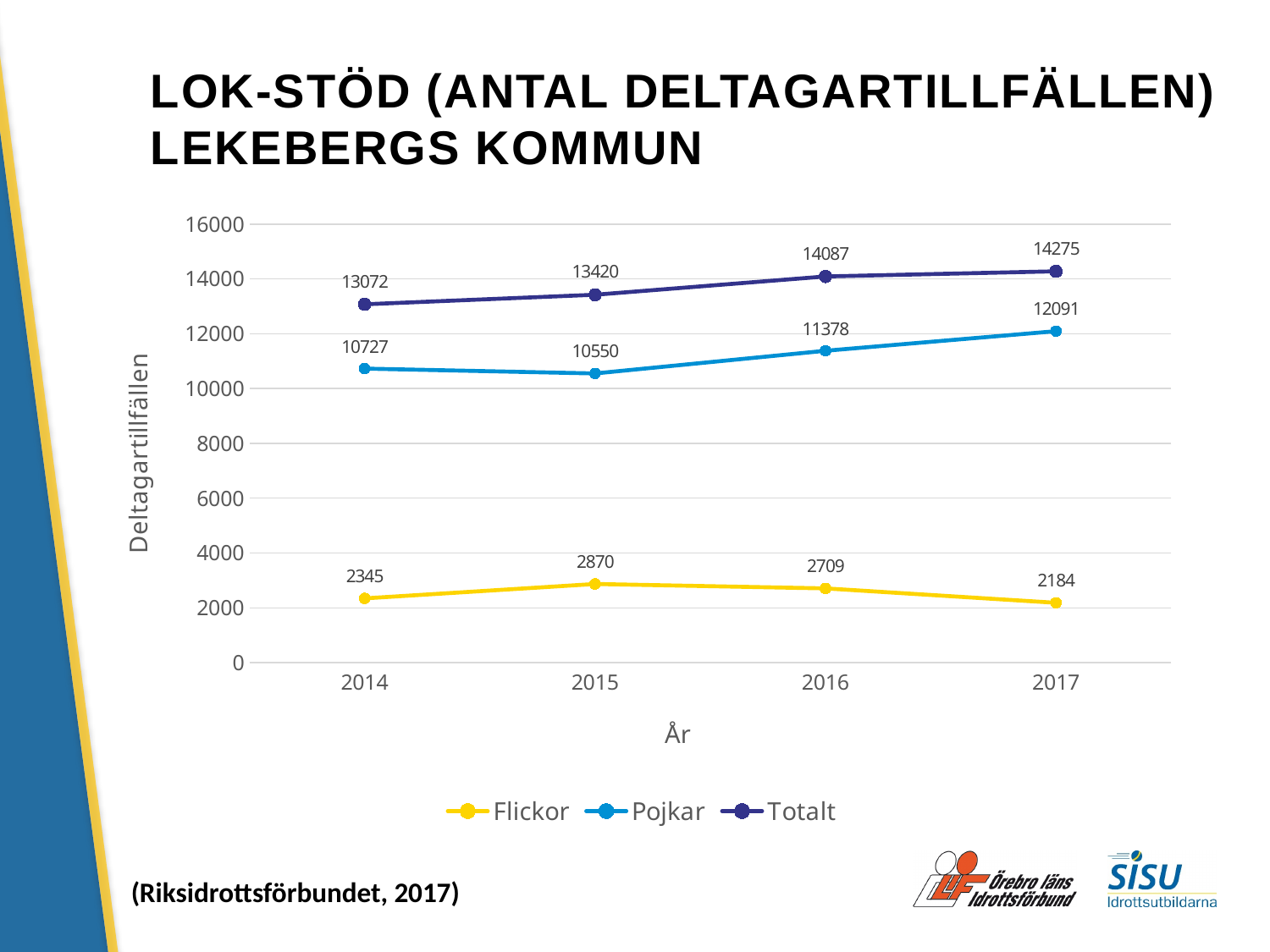
What is the value for Flickor in 2015? 2870 How many years are shown on the x axis? 4 How many series does the legend list? 3 In which year is the Totalt series highest? 2017 What is the value for Totalt in 2014? 13072 What is the difference between the Pojkar values in 2017 and 2014? 1364 In which year is the Flickor series lowest? 2017 Does the Totalt series rise or fall from 2014 to 2017? rise What is the value for Pojkar in 2016? 11378 Which is larger, the Flickor value in 2014 or in 2016? 2016 What kind of chart is shown on the slide? line chart Is the value for Pojkar in 2015 greater or less than 12000? less